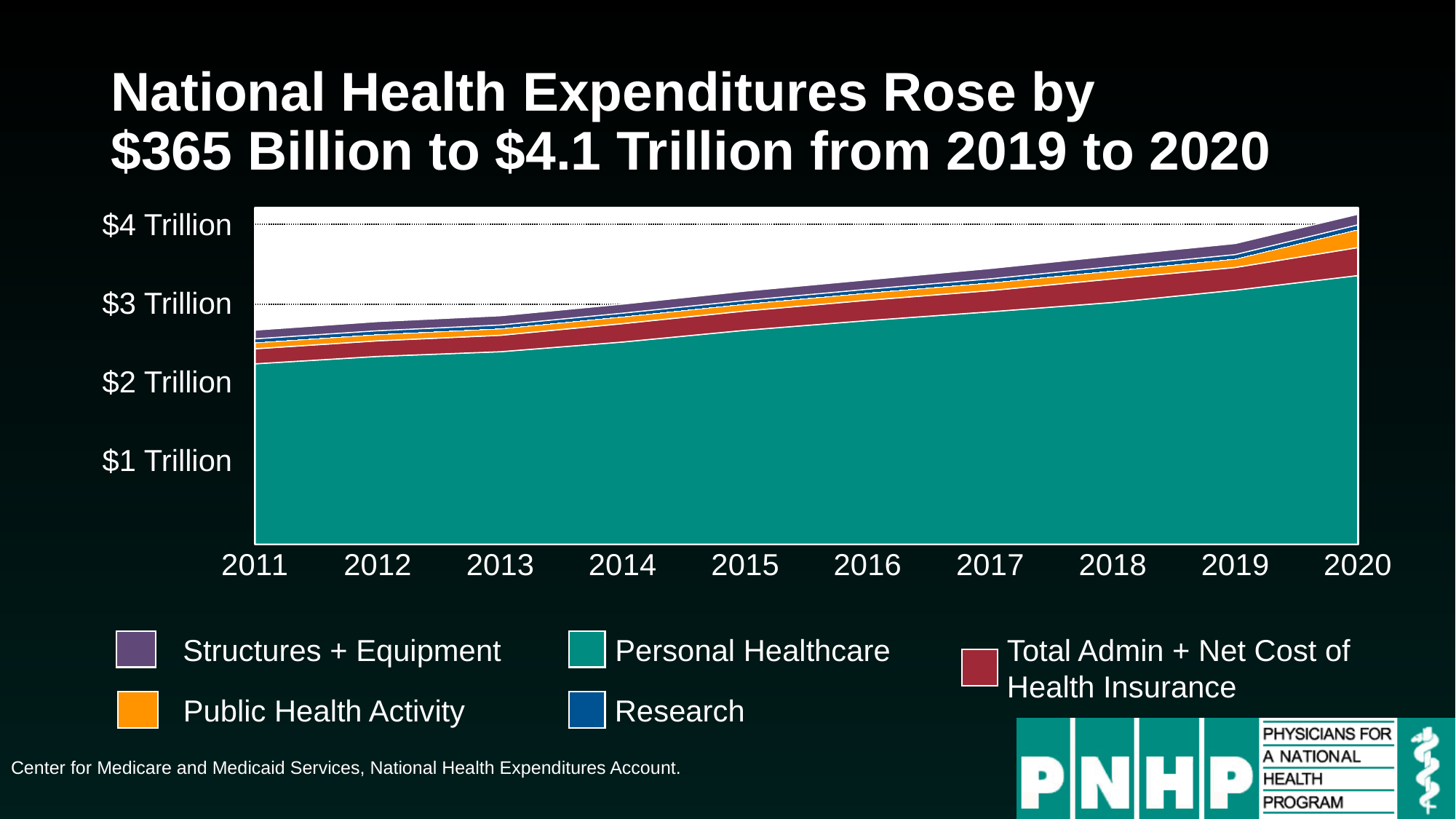
Which series is shown in orange in the chart? Public Health Activity Is the value for Personal Healthcare in 2011 greater or less than $2 Trillion? greater Do total national health expenditures rise or fall from 2011 to 2020? Rise Is the total national health expenditure in 2011 greater or less than $3 Trillion? less Is the value for Personal Healthcare in 2020 greater or less than $3 Trillion? greater How many series does the legend list? 5 Which series accounts for the largest share of national health expenditures in every year shown? Personal Healthcare According to the slide title, by how much did national health expenditures rise from 2019 to 2020? $365 Billion What kind of chart is shown on the slide? Stacked area chart How many years are shown along the x axis of the chart? 10 Which series accounts for the smallest share of national health expenditures in the chart? Research